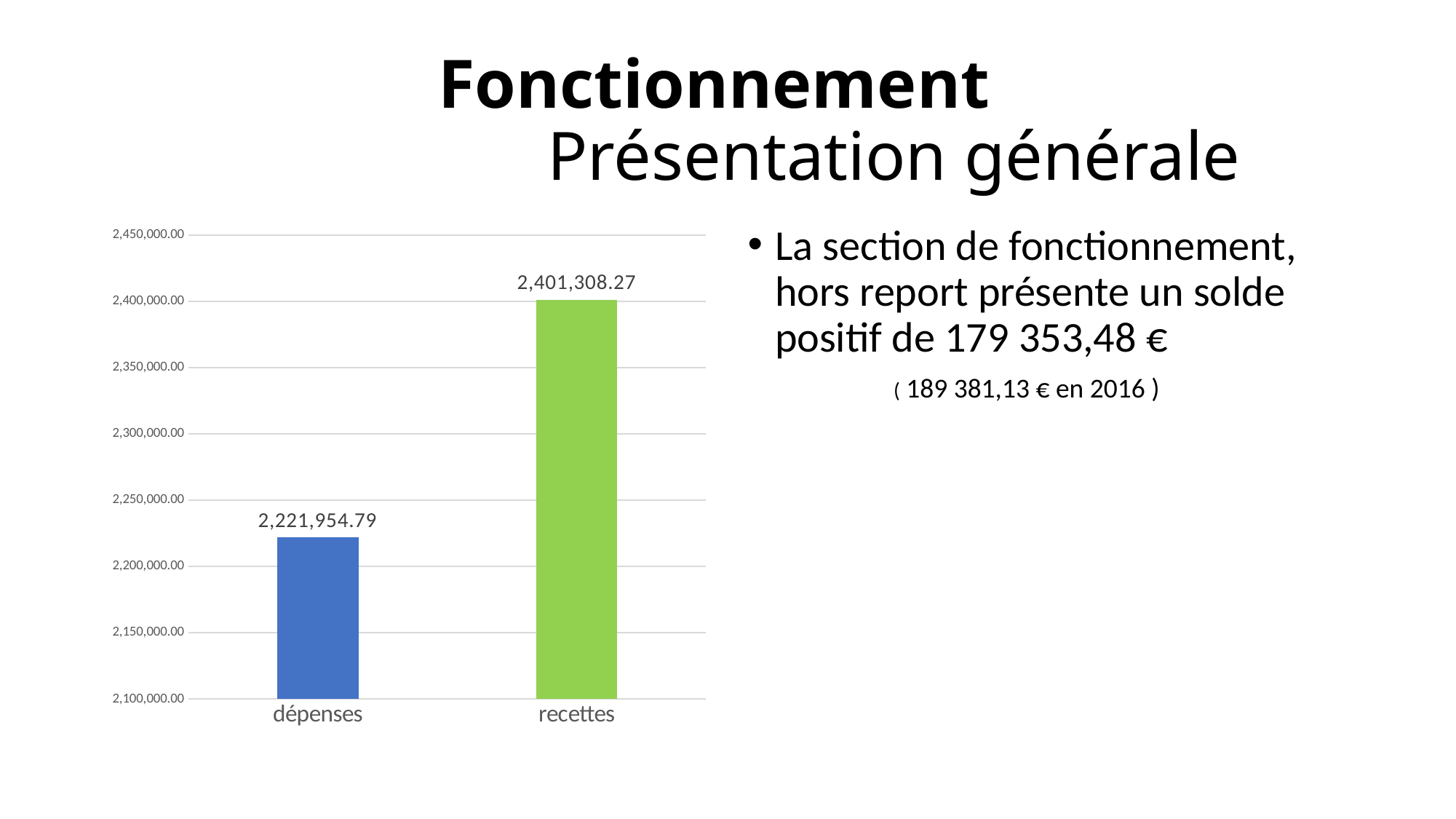
What colour is the bar for dépenses? blue What kind of chart is shown on the slide? bar chart What is the difference between recettes and dépenses? 179,353.48 What is the value for dépenses? 2,221,954.79 Which category has the lowest value? dépenses Is the value for dépenses greater or less than 2,250,000.00? less What is the value for recettes? 2,401,308.27 Which is larger, dépenses or recettes? recettes How many categories are shown in the chart? 2 Which category has the highest value? recettes Is the value for recettes greater or less than 2,400,000.00? greater What colour is the bar for recettes? green